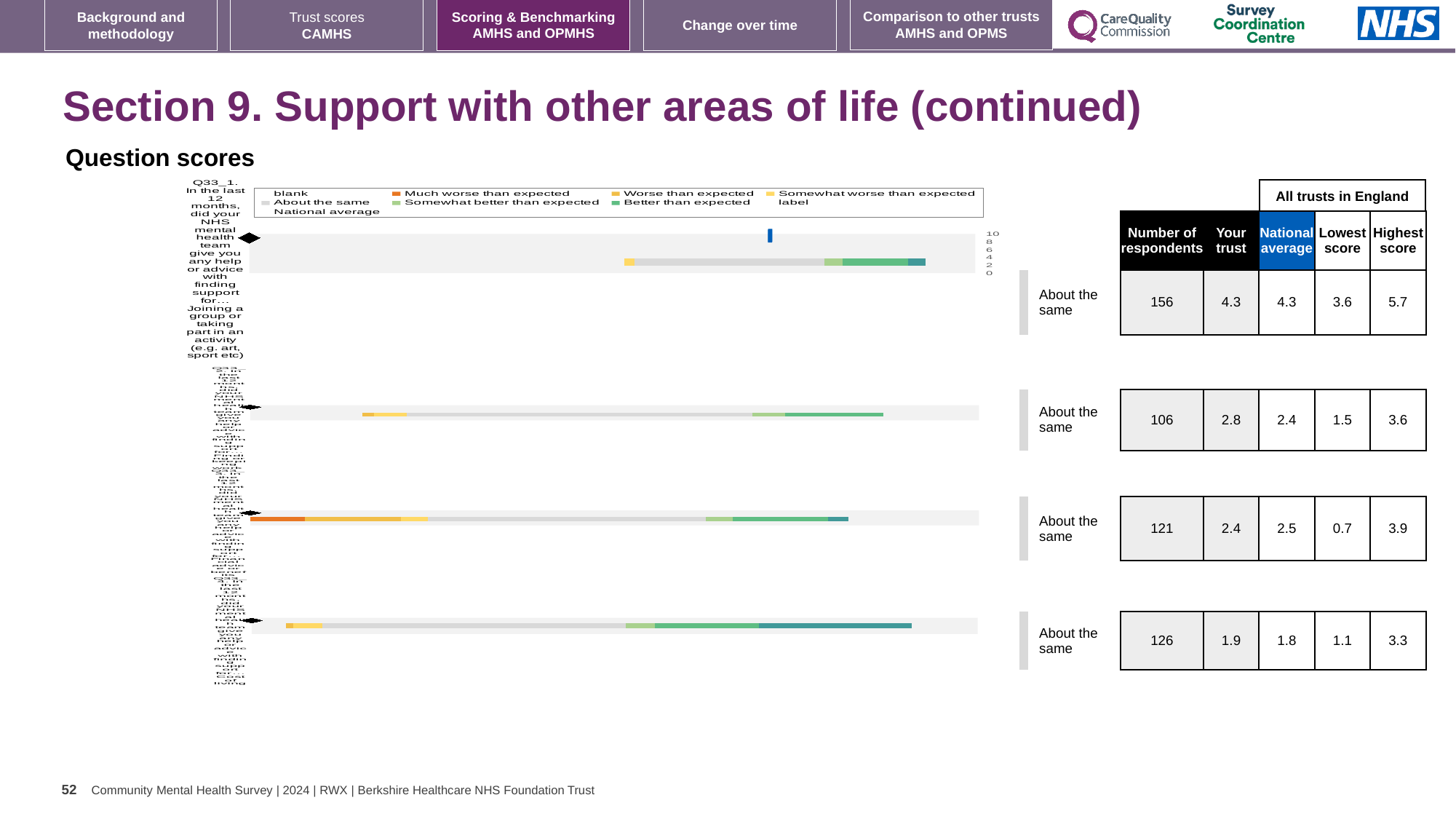
In the table beside the chart, what is the lowest score for the third row? 0.7 How many entries does the chart's legend list? 9 How many question rows (bars) does the chart show? 4 In the table beside the chart, what is the highest score for the second row? 3.6 In the table beside the chart, for the second row, which is larger: the 'Your trust' score or the national average? Your trust (2.8) Which legend entry is listed first in the chart's legend? blank What kind of chart is shown under 'Question scores'? bar chart What is the heading printed directly above the chart? Question scores In the table beside the chart, which row has the highest number of respondents? the first row (156) In the table beside the chart, what is the number of respondents for the first row (Q33_1, joining a group or taking part in an activity)? 156 In the table beside the chart, what is the 'Your trust' score for the first row (Q33_1)? 4.3 In the table beside the chart, what is the difference between the highest score and the lowest score for the first row? 2.1